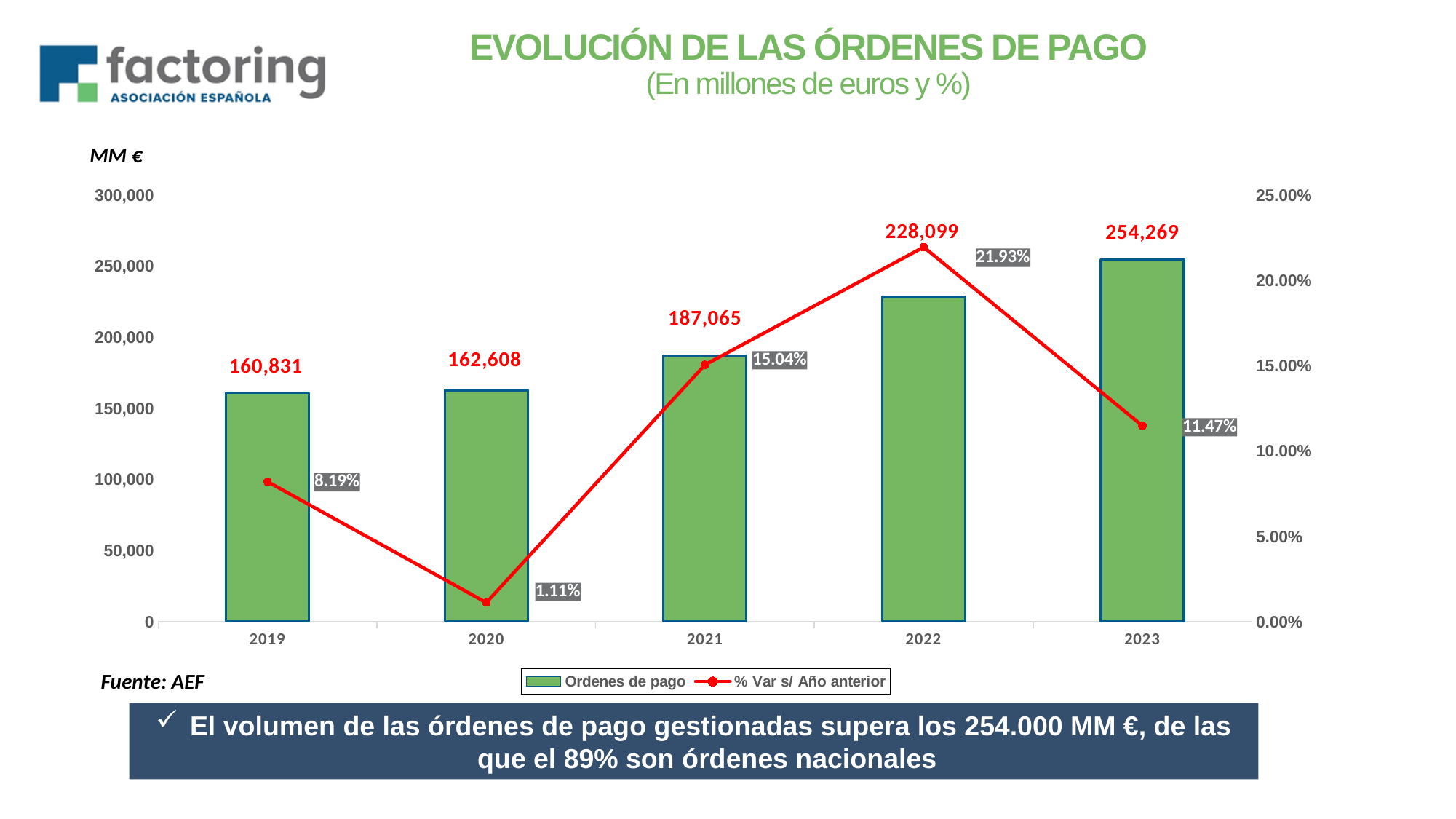
Is the value of Ordenes de pago for 2022 greater or less than 200,000? greater What is the title of the chart? EVOLUCIÓN DE LAS ÓRDENES DE PAGO Which year has the highest value of Ordenes de pago? 2023 How many series does the legend list? 2 Which is larger, the % Var s/ Año anterior for 2019 or for 2023? 2023 What is the % Var s/ Año anterior for 2022? 21.93% What is the value of Ordenes de pago for 2021? 187,065 Do the Ordenes de pago values rise or fall from 2019 to 2023? rise Which year has the lowest % Var s/ Año anterior? 2020 What is the value of Ordenes de pago for 2019? 160,831 What is the difference in Ordenes de pago between 2023 and 2022? 26,170 How many years are shown on the x axis? 5